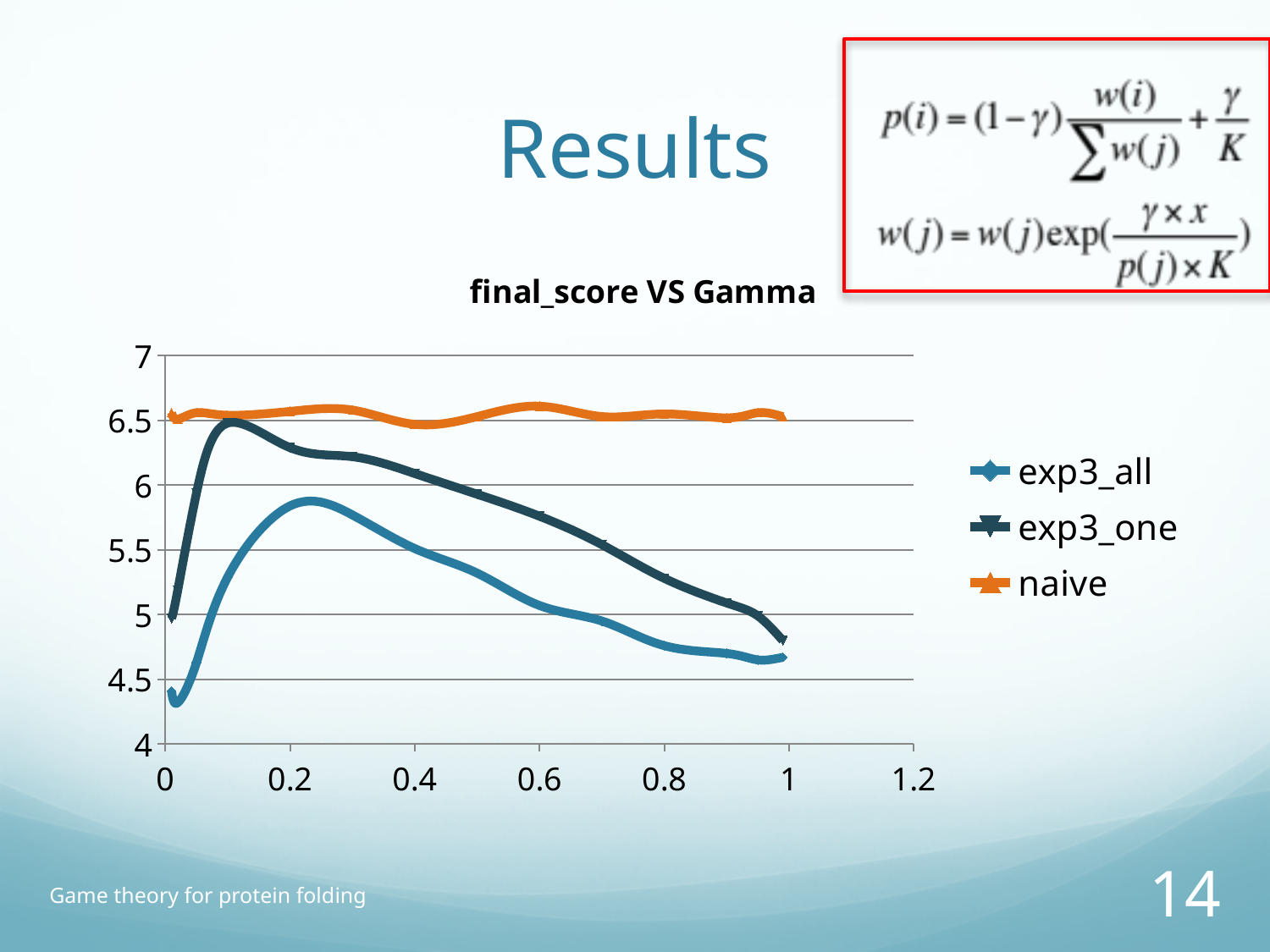
Is the value for exp3_all at Gamma 0.2 greater or less than 5.5? greater Is the value for exp3_all at Gamma 0 greater or less than 4.5? less Which series is shown in orange in the legend? naive At Gamma 0.6, which series has the larger value, exp3_one or exp3_all? exp3_one Is the value for naive at Gamma 0.8 greater or less than 6? greater What kind of chart is shown on the slide? line chart Which series has the highest values across the whole range of Gamma? naive Which series reaches the lowest value on the chart? exp3_all Does the exp3_one series rise or fall as Gamma increases from 0.2 to 1? fall How many series does the legend list? 3 What is the title of the chart? final_score VS Gamma